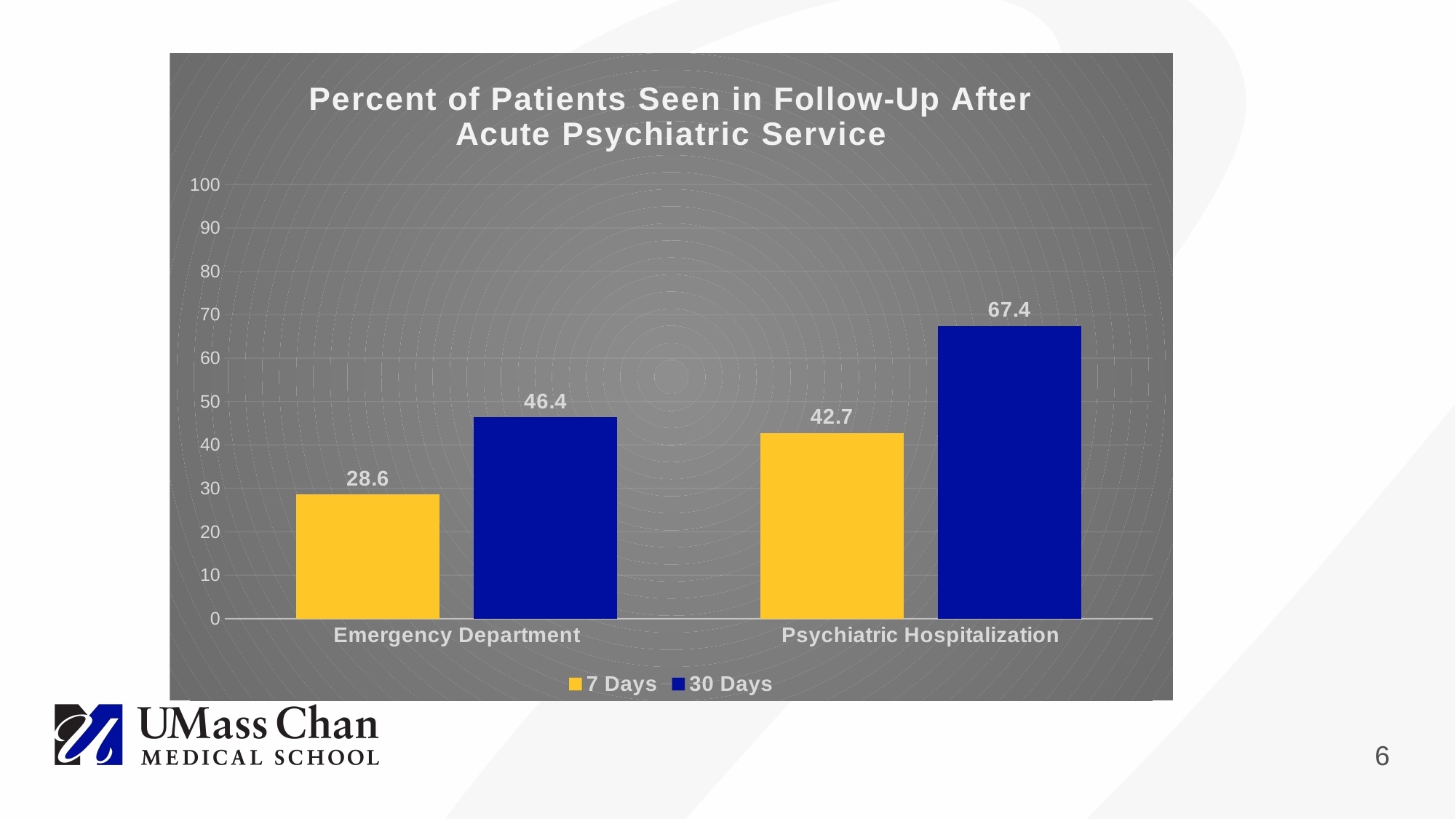
What is the 7 Days value for Emergency Department? 28.6 What kind of chart is shown on the slide? Bar chart How many categories are shown on the x axis? 2 Which category has the lowest 7 Days value? Emergency Department What is the 7 Days value for Psychiatric Hospitalization? 42.7 Which is larger: the 30 Days value for Emergency Department or the 7 Days value for Psychiatric Hospitalization? 30 Days value for Emergency Department Which category has the highest 30 Days value? Psychiatric Hospitalization What is the 30 Days value for Emergency Department? 46.4 What is the difference between the 30 Days and 7 Days values for Psychiatric Hospitalization? 24.7 How many series does the legend list? 2 What is the 30 Days value for Psychiatric Hospitalization? 67.4 What is the difference between the 30 Days values for Psychiatric Hospitalization and Emergency Department? 21